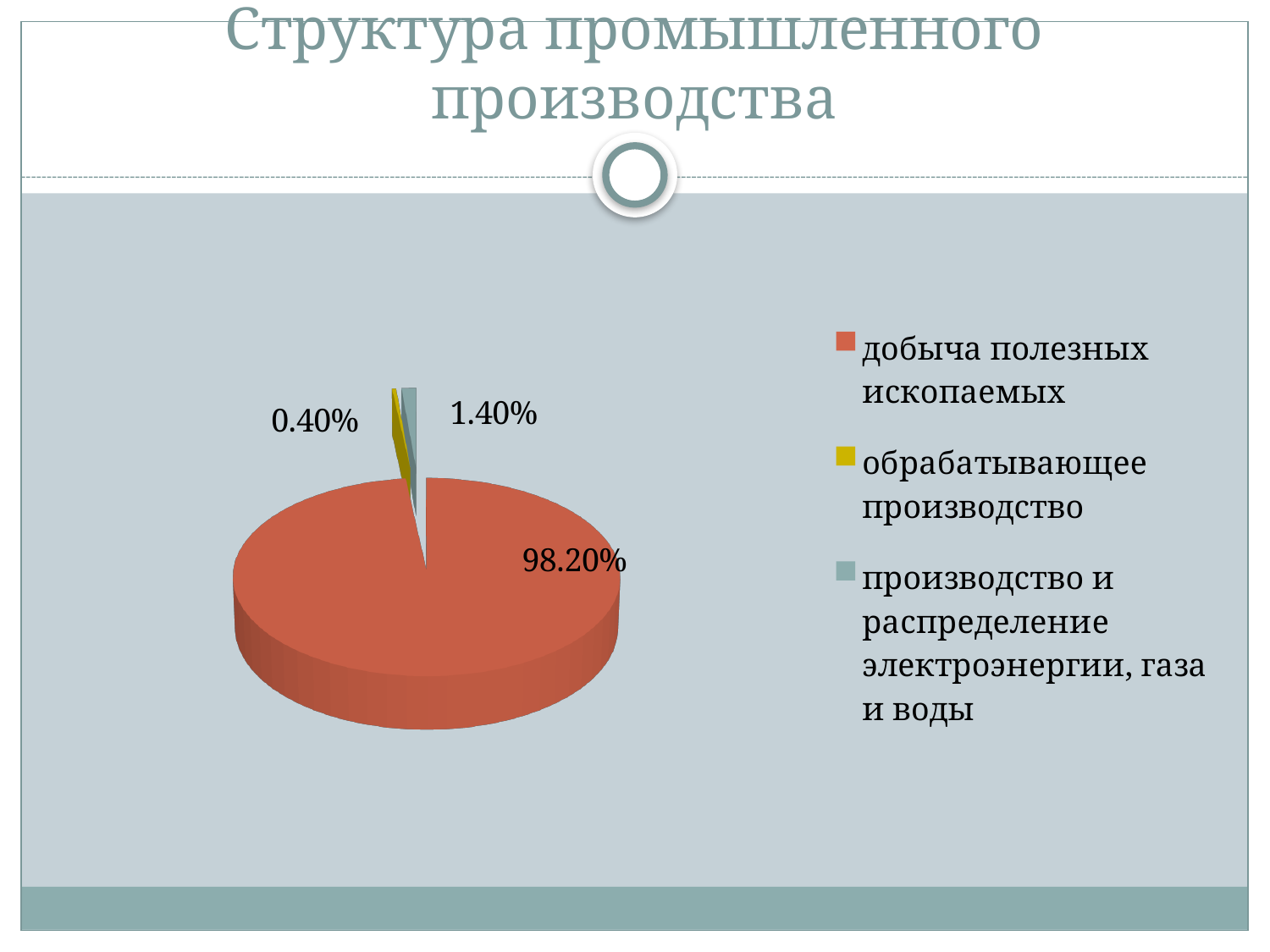
What colour is the slice for "добыча полезных ископаемых"? red Which is larger: the share of "обрабатывающее производство" or the share of "производство и распределение электроэнергии, газа и воды"? производство и распределение электроэнергии, газа и воды What is the difference between the shares of "производство и распределение электроэнергии, газа и воды" and "обрабатывающее производство"? 1.00% What share of the pie does "производство и распределение электроэнергии, газа и воды" have? 1.40% What share of the pie does "добыча полезных ископаемых" have? 98.20% How many entries does the legend list? 3 What is the title of the chart slide? Структура промышленного производства Which category has the smallest slice of the pie? обрабатывающее производство What kind of chart is shown on the slide? pie chart How many slices does the pie chart have? 3 What share of the pie does "обрабатывающее производство" have? 0.40% Which category has the largest slice of the pie? добыча полезных ископаемых